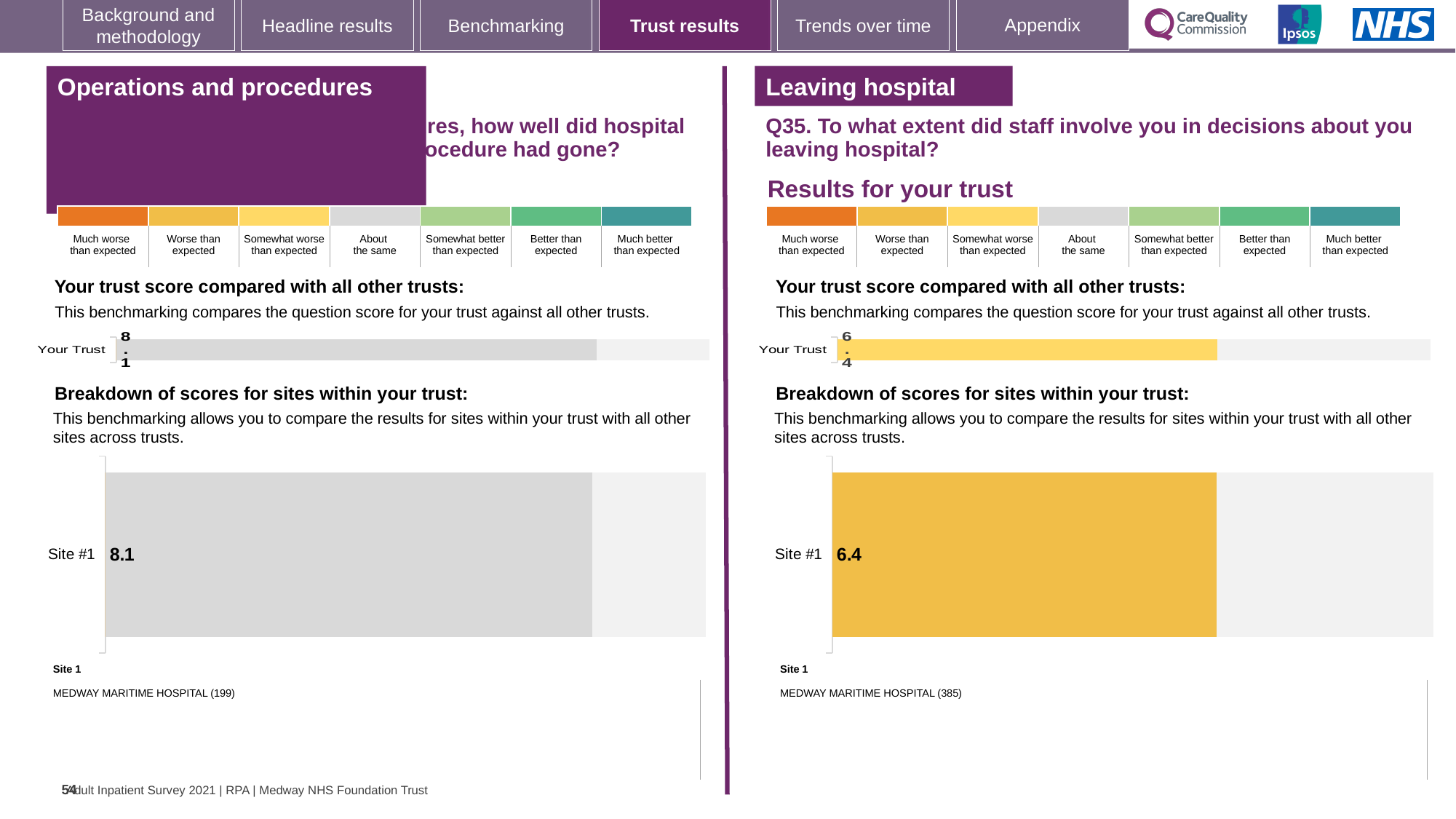
In the 'Operations and procedures' section, which rating category does the colour of the Site #1 bar correspond to in the colour key? About the same In the 'Leaving hospital' section, which rating category does the colour of the 'Your Trust' bar correspond to in the colour key? Somewhat worse than expected In the 'Leaving hospital' section, what score is shown for Site #1 in the breakdown of sites chart? 6.4 What type of chart is used to show the 'Your Trust' score in the 'Leaving hospital' section? Bar chart In the 'Leaving hospital' section, is the Site #1 score greater or less than the 'Your Trust' score in the 'Operations and procedures' section? less How many rating categories are shown in the colour key above the 'Leaving hospital' charts? 7 In the 'Operations and procedures' section, what is the 'Your Trust' score shown in the trust comparison bar chart? 8.1 What is the difference between the Site #1 score in the 'Operations and procedures' section and the Site #1 score in the 'Leaving hospital' section? 1.7 In the 'Leaving hospital' section, what is the 'Your Trust' score shown in the trust comparison bar chart? 6.4 How many sites are shown in the 'Breakdown of scores for sites within your trust' chart in the 'Leaving hospital' section? 1 In the 'Operations and procedures' section, what score is shown for Site #1 in the breakdown of sites chart? 8.1 Which section shows the higher 'Your Trust' score: 'Operations and procedures' or 'Leaving hospital'? Operations and procedures